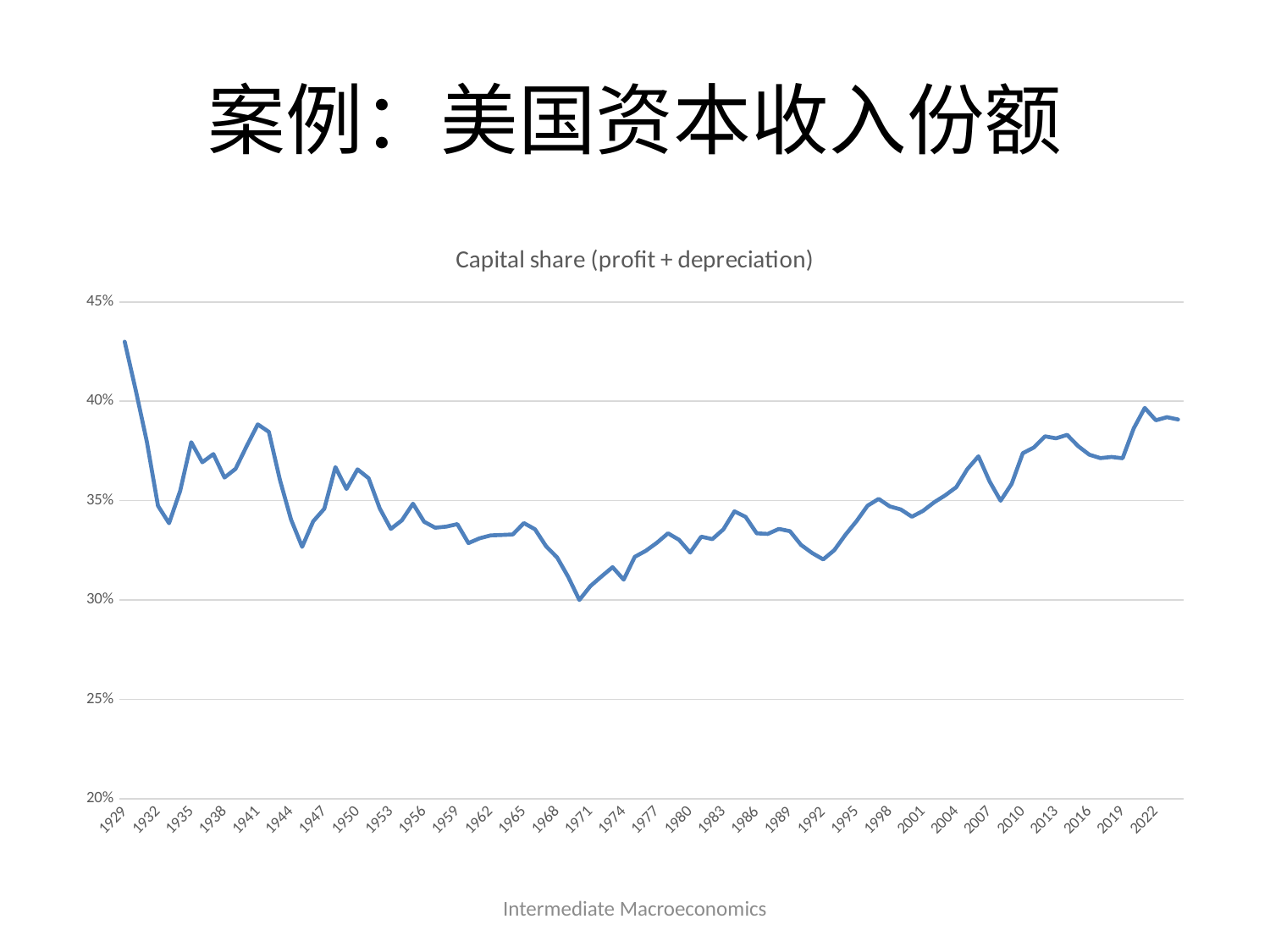
Does the capital share generally rise or fall between 1992 and 2022? rise Is the value for 2022 greater or less than 35%? greater Which is larger, the capital share in 1971 or in 2022? 2022 Does the capital share rise or fall between 1929 and 1932? fall Is the value for 1929 greater or less than 40%? greater Is the value for 2007 greater or less than 35%? greater What kind of chart is shown on the slide? line chart Which is larger, the capital share in 1929 or in 2022? 1929 What is the title of the chart? Capital share (profit + depreciation) Which year has the highest capital share on the chart? 1929